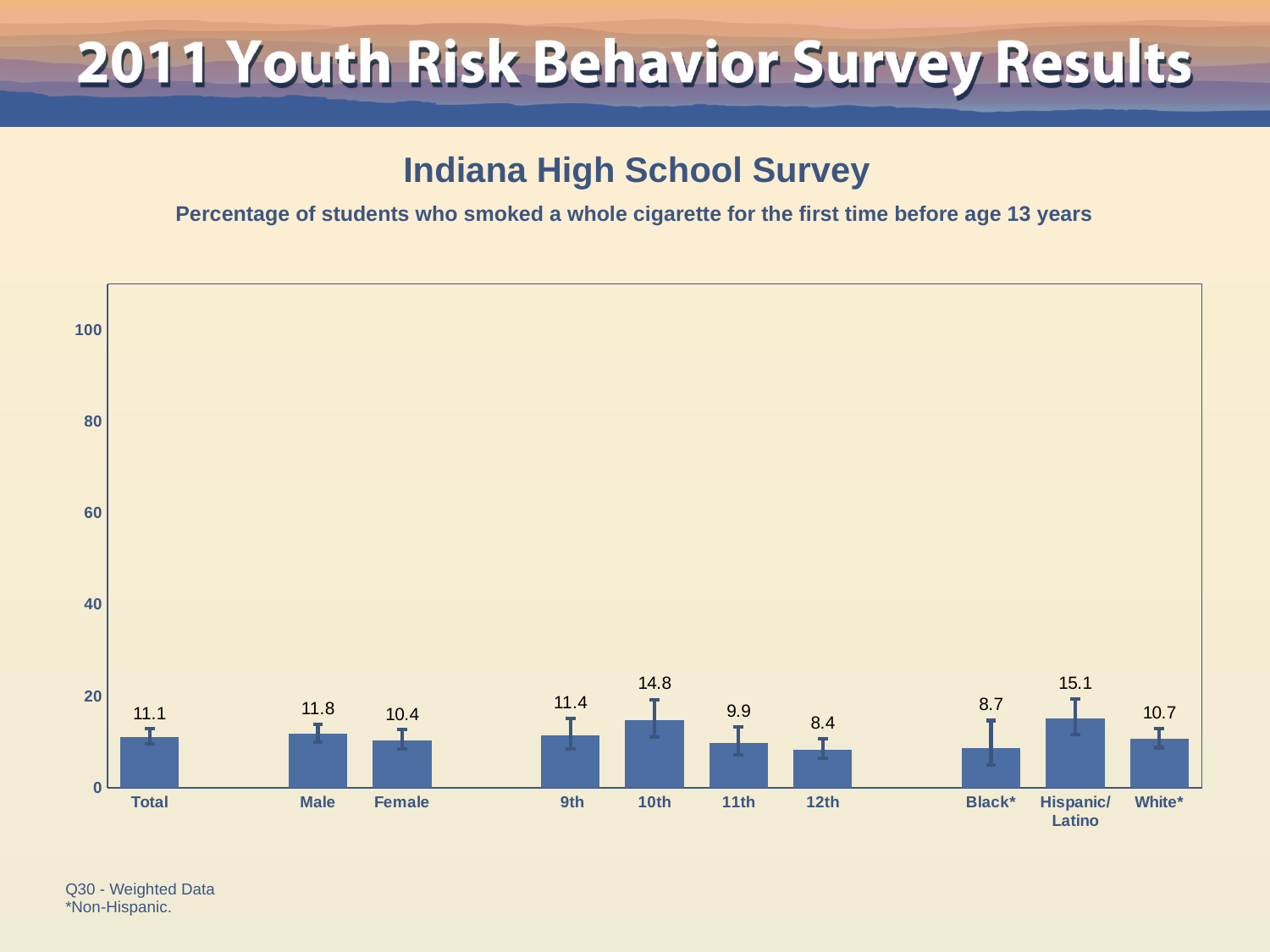
What kind of chart is this? bar chart What is the value for Total? 11.1 What is the difference between the Male and Female values? 1.4 What is the subtitle describing what the chart measures? Percentage of students who smoked a whole cigarette for the first time before age 13 years What is the value for Black*? 8.7 What is the value for 10th grade? 14.8 How many categories are shown on the x axis? 10 What is the value for Female? 10.4 Which category has the highest value? Hispanic/Latino Which category has the lowest value? 12th Is the value for Hispanic/Latino greater or less than 20? less Which is larger, the value for 9th or the value for 11th? 9th